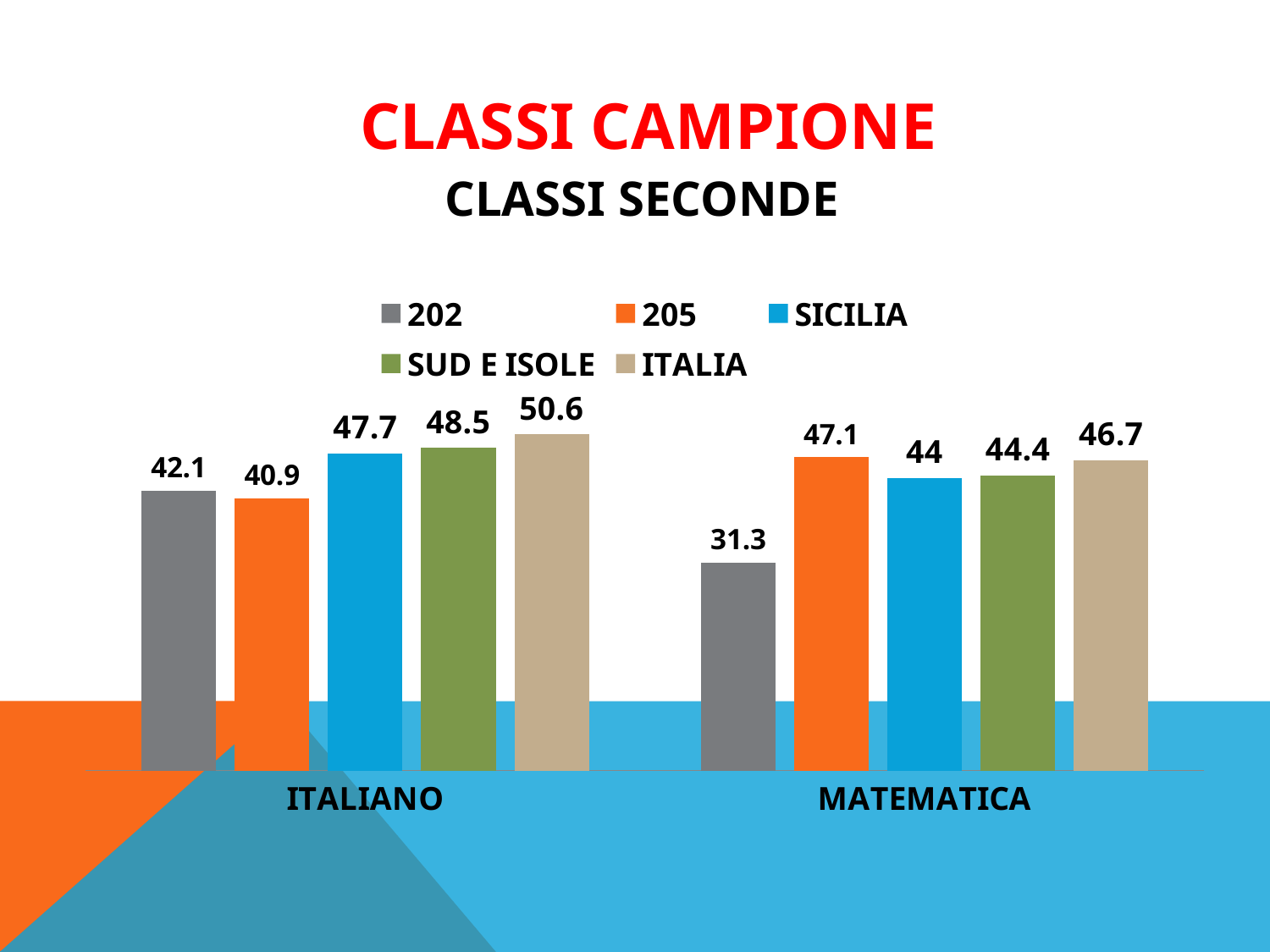
What is the value for series 205 in the MATEMATICA category? 47.1 How many categories are shown on the x axis? 2 Which is larger in the MATEMATICA category: the value for 205 or the value for SICILIA? 205 Which series has the lowest value in the MATEMATICA category? 202 How many series does the legend list? 5 What colour are the bars for the SUD E ISOLE series? Green What is the value for SICILIA in the ITALIANO category? 47.7 What is the value for ITALIA in the MATEMATICA category? 46.7 What is the value for series 202 in the ITALIANO category? 42.1 Which series has the highest value in the ITALIANO category? ITALIA What kind of chart is shown on the slide? Bar chart What is the difference between the ITALIA value and the 202 value in the ITALIANO category? 8.5